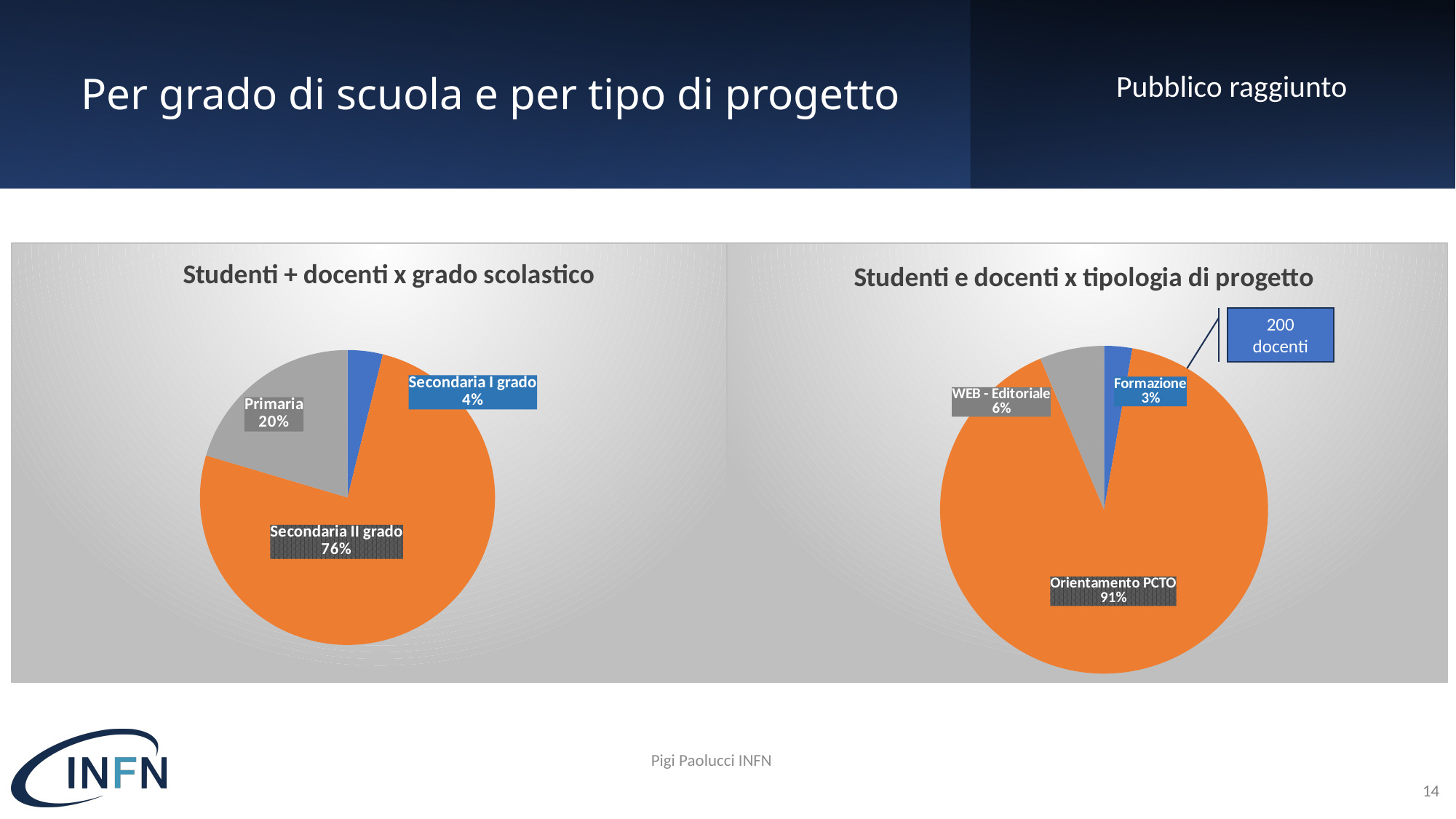
In the chart 'Studenti + docenti x grado scolastico', what share does Primaria have? 20% In the chart 'Studenti e docenti x tipologia di progetto', which is larger, WEB - Editoriale or Formazione? WEB - Editoriale In the chart 'Studenti + docenti x grado scolastico', what share does Secondaria I grado have? 4% In the chart 'Studenti + docenti x grado scolastico', which category has the largest slice? Secondaria II grado In the chart 'Studenti + docenti x grado scolastico', what is the difference in percentage points between Primaria and Secondaria I grado? 16 What kind of chart is 'Studenti e docenti x tipologia di progetto'? Pie chart In the chart 'Studenti + docenti x grado scolastico', what share does Secondaria II grado have? 76% In the chart 'Studenti + docenti x grado scolastico', how many categories are shown? 3 In the chart 'Studenti + docenti x grado scolastico', which category has the smallest slice? Secondaria I grado In the chart 'Studenti e docenti x tipologia di progetto', which category has the smallest slice? Formazione